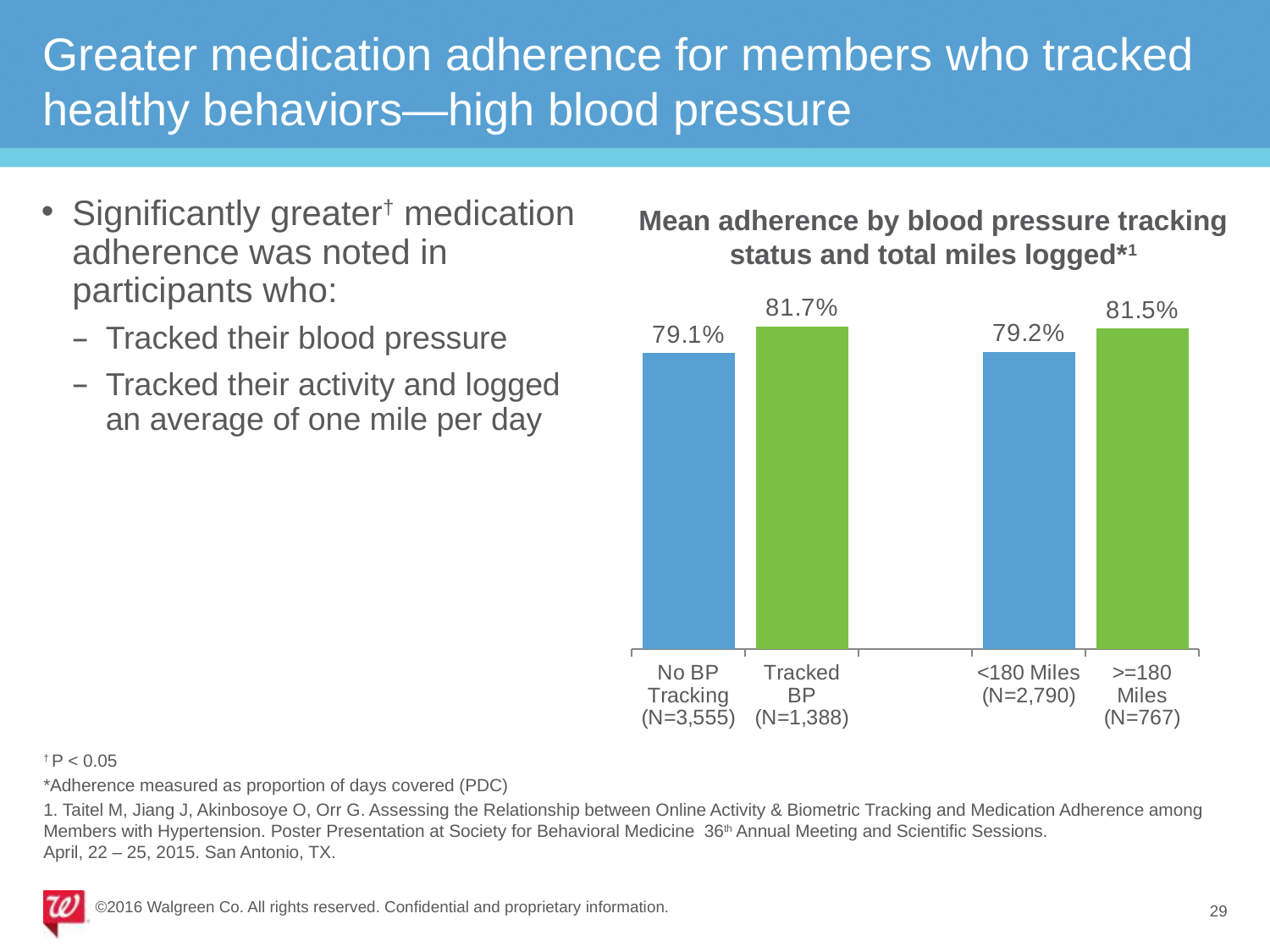
What is the difference in mean adherence between the >=180 Miles and <180 Miles groups? 2.3% What is the mean adherence for the No BP Tracking group? 79.1% Which group has the lowest mean adherence? No BP Tracking What is the difference in mean adherence between the Tracked BP and No BP Tracking groups? 2.6% How many groups are shown in the chart? 4 What is the mean adherence for the <180 Miles group? 79.2% What is the mean adherence for the >=180 Miles group? 81.5% What is the sample size (N) for the Tracked BP group? 1,388 Which group has the highest mean adherence? Tracked BP Which has higher mean adherence, the <180 Miles group or the >=180 Miles group? >=180 Miles What kind of chart is shown on the slide? Bar chart What is the mean adherence for the Tracked BP group? 81.7%